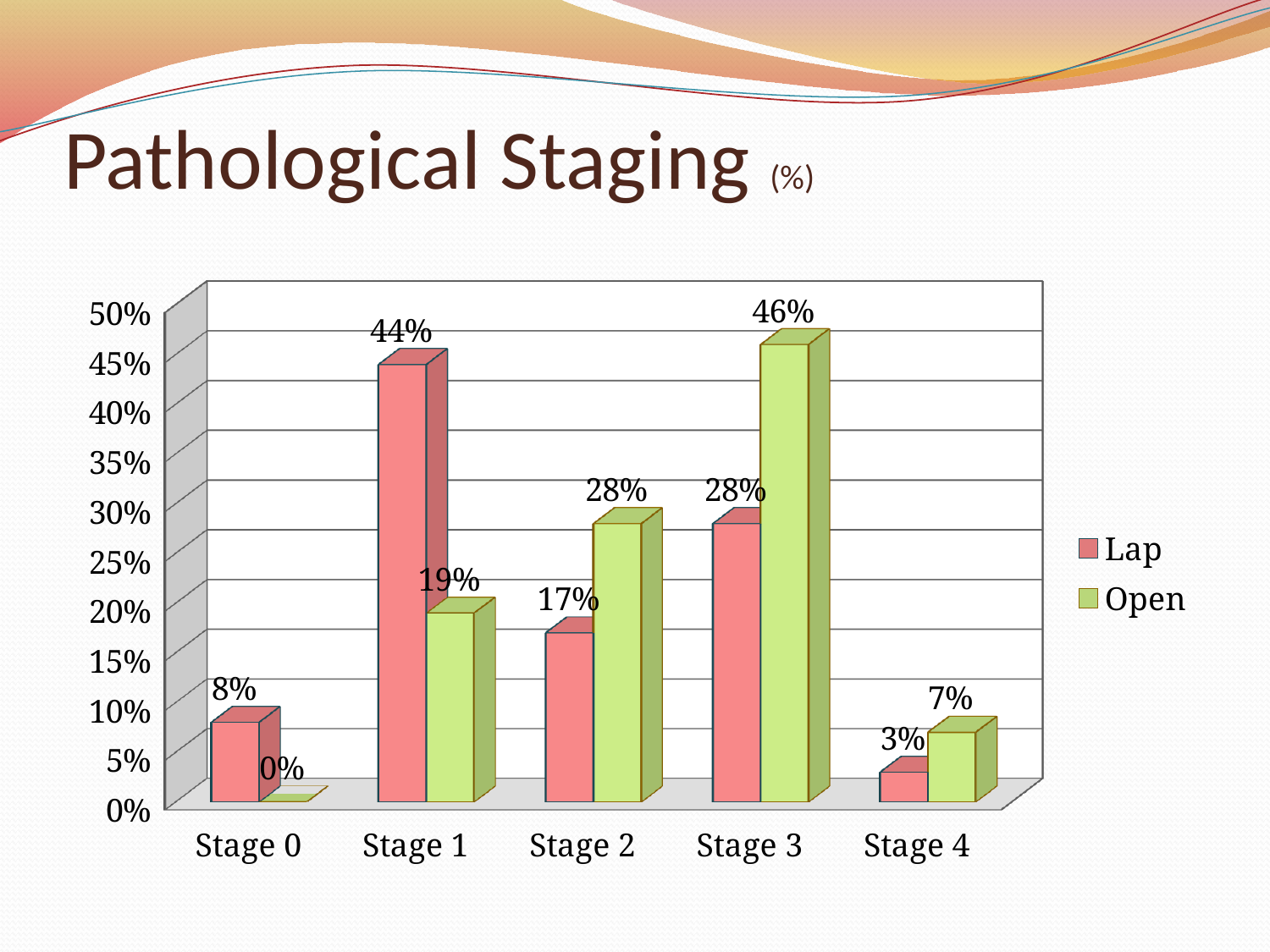
How many stages are shown on the x axis? 5 Which series is shown in green in the legend? Open What kind of chart is shown on the slide? Bar chart Which is larger for Stage 2, the Lap value or the Open value? Open How many series does the legend list? 2 What is the Open value for Stage 0? 0% Which stage has the lowest Open value? Stage 0 What is the difference between the Lap and Open values for Stage 1? 25% What is the Open value for Stage 3? 46% Which stage has the highest Lap value? Stage 1 What is the Lap value for Stage 1? 44% What is the Lap value for Stage 4? 3%